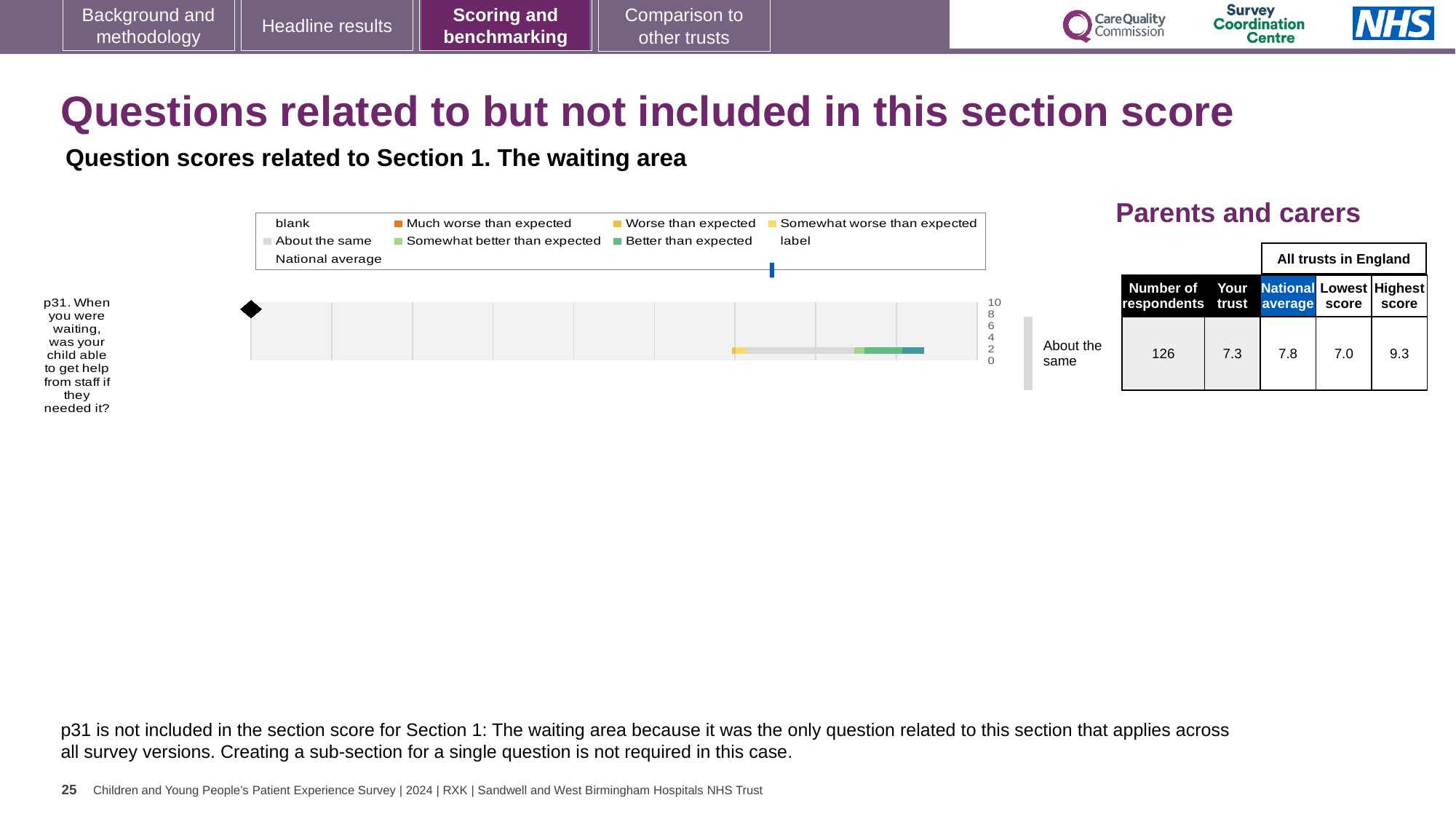
What is the benchmark category shown next to the bar for p31? About the same What is the Lowest score among all trusts in England for p31? 7.0 What is the National average score for p31? 7.8 How many respondents answered p31? 126 Which question is plotted in the chart? p31. When you were waiting, was your child able to get help from staff if they needed it? What is the maximum value shown on the chart's score axis? 10 What is the Highest score among all trusts in England for p31? 9.3 What is the 'Your trust' score for p31 in the Parents and carers table? 7.3 How many questions are plotted in the chart? 1 Which is larger for p31, the Your trust score or the National average? National average What kind of chart is used to show the p31 question score? bar chart What is the difference between the Highest score and the Lowest score for p31? 2.3